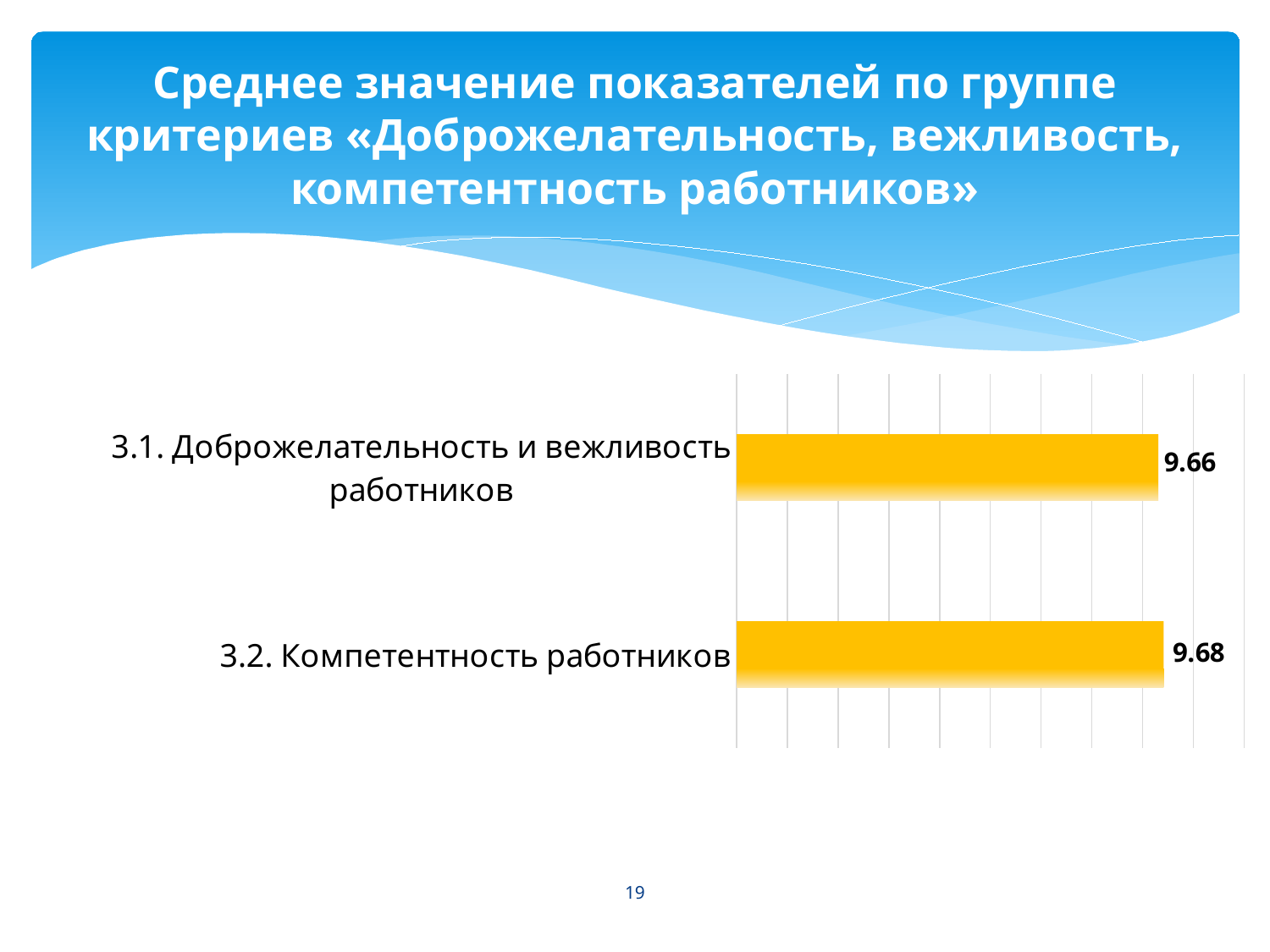
Which category has the highest value? 3.2. Компетентность работников What is the difference between the values for «3.2. Компетентность работников» and «3.1. Доброжелательность и вежливость работников»? 0.02 How many categories are shown in the chart? 2 What is the value for «3.1. Доброжелательность и вежливость работников»? 9.66 What kind of chart is shown on the slide? Bar chart Which category has the lowest value? 3.1. Доброжелательность и вежливость работников What is the value for «3.2. Компетентность работников»? 9.68 What is the title of the slide? Среднее значение показателей по группе критериев «Доброжелательность, вежливость, компетентность работников» Which is larger: the value for «3.1. Доброжелательность и вежливость работников» or for «3.2. Компетентность работников»? 3.2. Компетентность работников What colour are the bars in the chart? Yellow